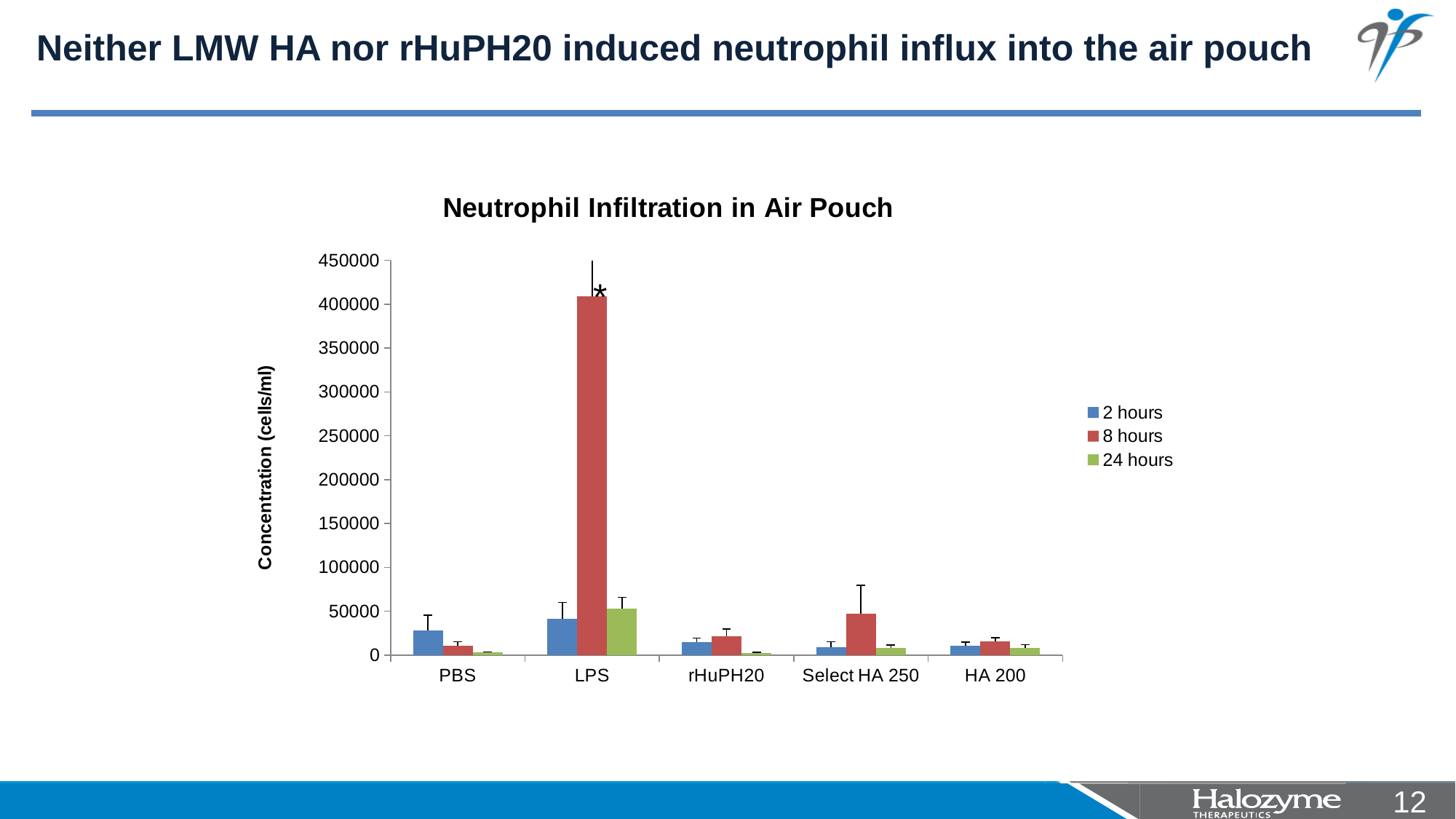
What is the title of the chart? Neutrophil Infiltration in Air Pouch Which category has the highest 8 hours value? LPS For LPS, which is larger: the 2 hours value or the 8 hours value? 8 hours Is the 2 hours value for PBS greater or less than 50000? less For PBS, which is larger: the 2 hours value or the 8 hours value? 2 hours How many treatment categories are shown on the x axis? 5 What is the label on the y axis? Concentration (cells/ml) How many series does the legend list? 3 Is the 24 hours value for LPS greater or less than 100000? less What kind of chart is shown on the slide? bar chart For Select HA 250, which is larger: the 2 hours value or the 8 hours value? 8 hours Is the 8 hours value for LPS greater or less than 350000? greater